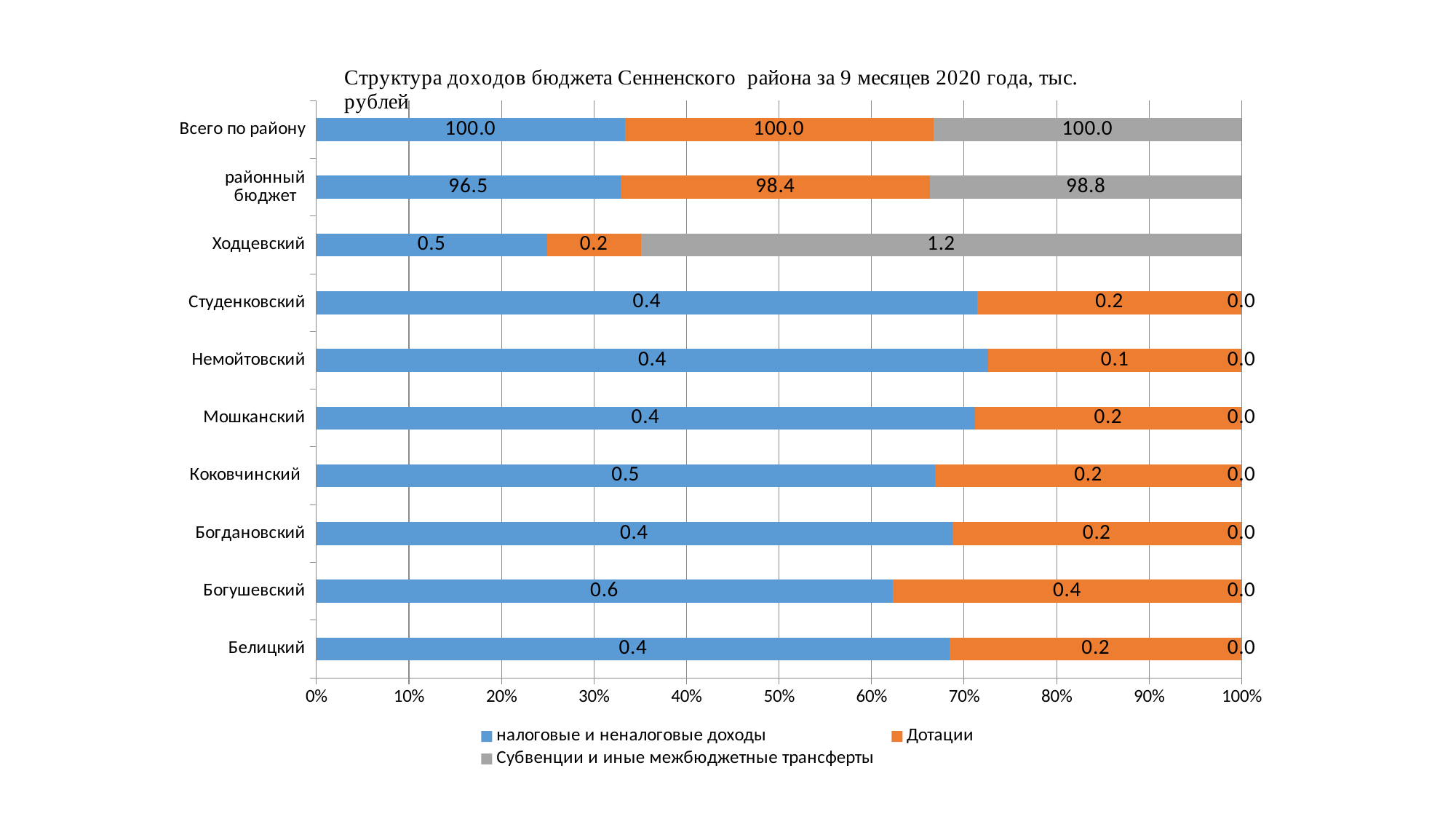
What kind of chart is shown on the slide? Stacked bar chart What is the value of Дотации for Немойтовский? 0.1 How many series does the legend list? 3 What colour represents Дотации in the chart? Orange What is the total of the three values in the stacked bar for Ходцевский? 1.9 What is the value of налоговые и неналоговые доходы for Богушевский? 0.6 What is the value of Субвенции и иные межбюджетные трансферты for Ходцевский? 1.2 What is the value of Дотации for районный бюджет? 98.4 Which is larger for Ходцевский: налоговые и неналоговые доходы or Субвенции и иные межбюджетные трансферты? Субвенции и иные межбюджетные трансферты Among the rural councils (excluding Всего по району and районный бюджет), which category has the highest value for налоговые и неналоговые доходы? Богушевский How many categories are shown on the vertical axis? 10 What is the difference between Субвенции и иные межбюджетные трансферты and Дотации for районный бюджет? 0.4